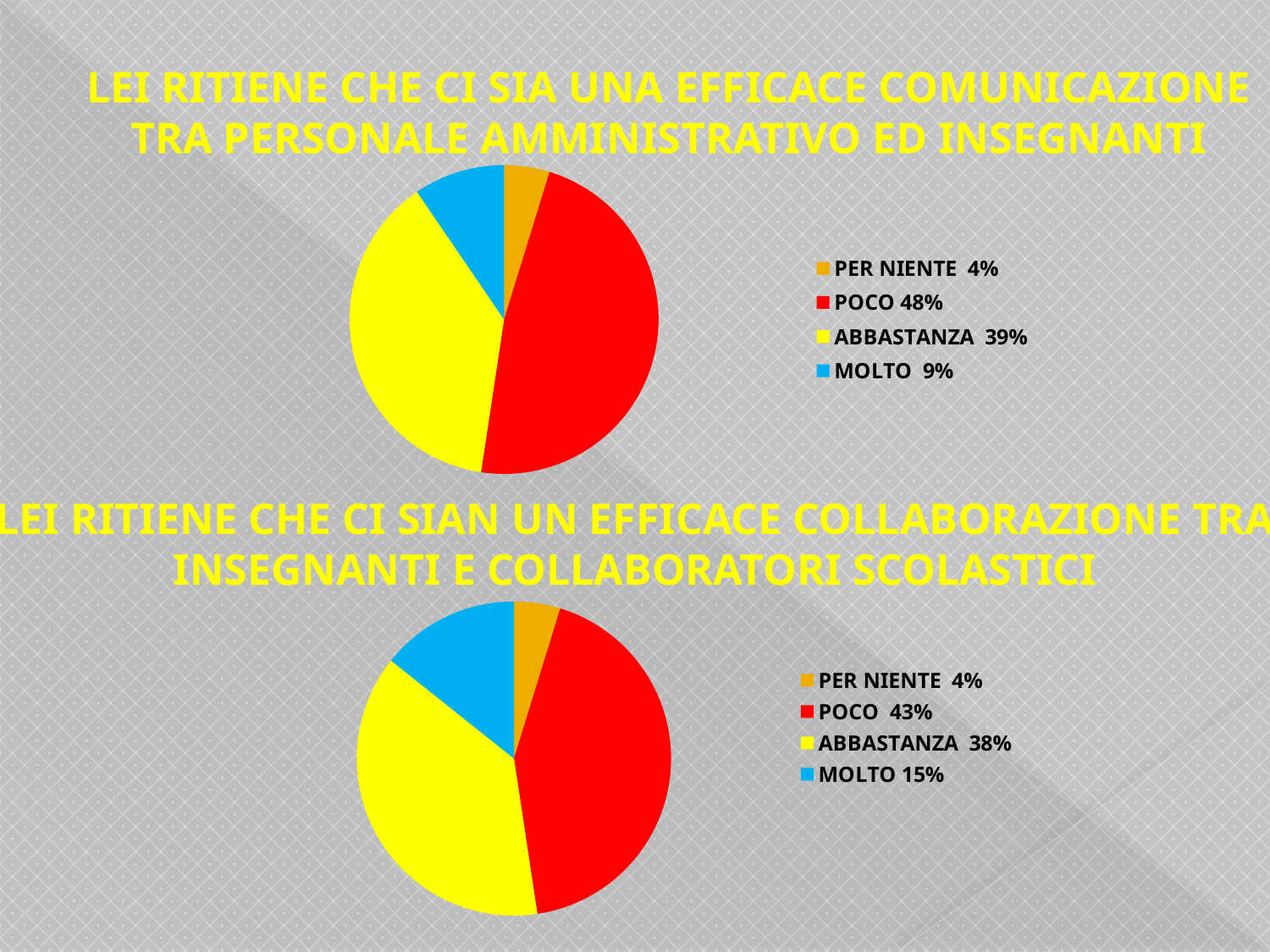
In the bottom pie chart, what percentage is shown for MOLTO? 15% In the top pie chart, what percentage is shown for POCO? 48% In the bottom pie chart, what is the difference in percentage points between MOLTO and PER NIENTE? 11 In the bottom pie chart, which category has the smallest share? PER NIENTE In the top pie chart, what colour represents ABBASTANZA? Yellow What type of chart is the bottom chart? Pie chart In the bottom pie chart, what percentage is shown for ABBASTANZA? 38% In the top pie chart, what percentage is shown for MOLTO? 9% In the bottom pie chart, which is larger, POCO or ABBASTANZA? POCO In the top pie chart, which category has the largest share? POCO How many categories does the legend of the top pie chart list? 4 In the top pie chart, what is the difference in percentage points between POCO and ABBASTANZA? 9